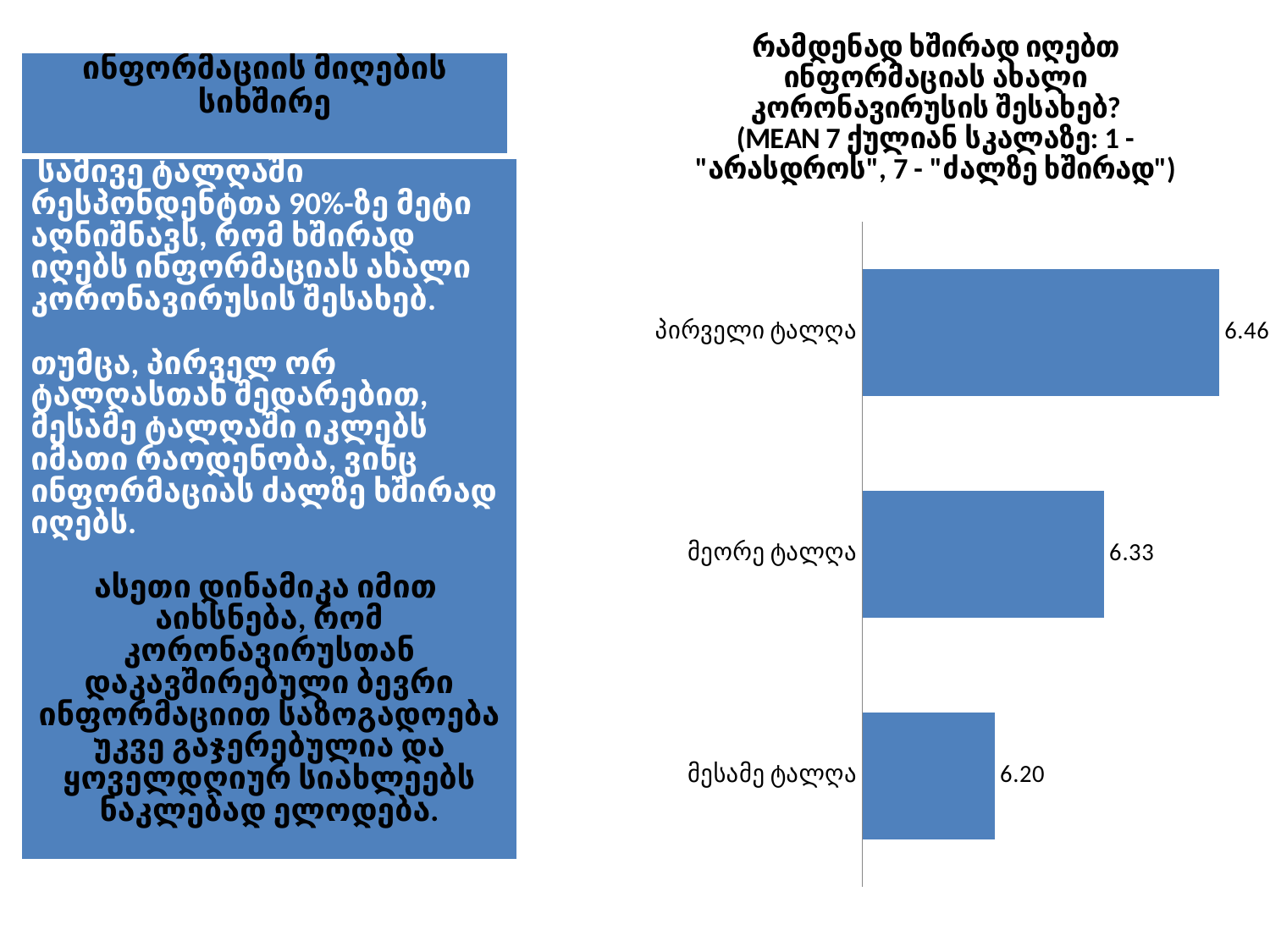
What is the difference between the values for პირველი ტალღა and მეორე ტალღა? 0.13 Which is larger, the value for მეორე ტალღა or მესამე ტალღა? მეორე ტალღა How many categories are shown in the chart? 3 Which category has the highest value? პირველი ტალღა Do the values rise or fall from პირველი ტალღა to მესამე ტალღა? fall What kind of chart is shown on the slide? bar chart What is the value for მეორე ტალღა? 6.33 What is the value for მესამე ტალღა? 6.20 What is the difference between the values for პირველი ტალღა and მესამე ტალღა? 0.26 Which category has the lowest value? მესამე ტალღა What is the value for პირველი ტალღა? 6.46 What colour are the bars in the chart? blue